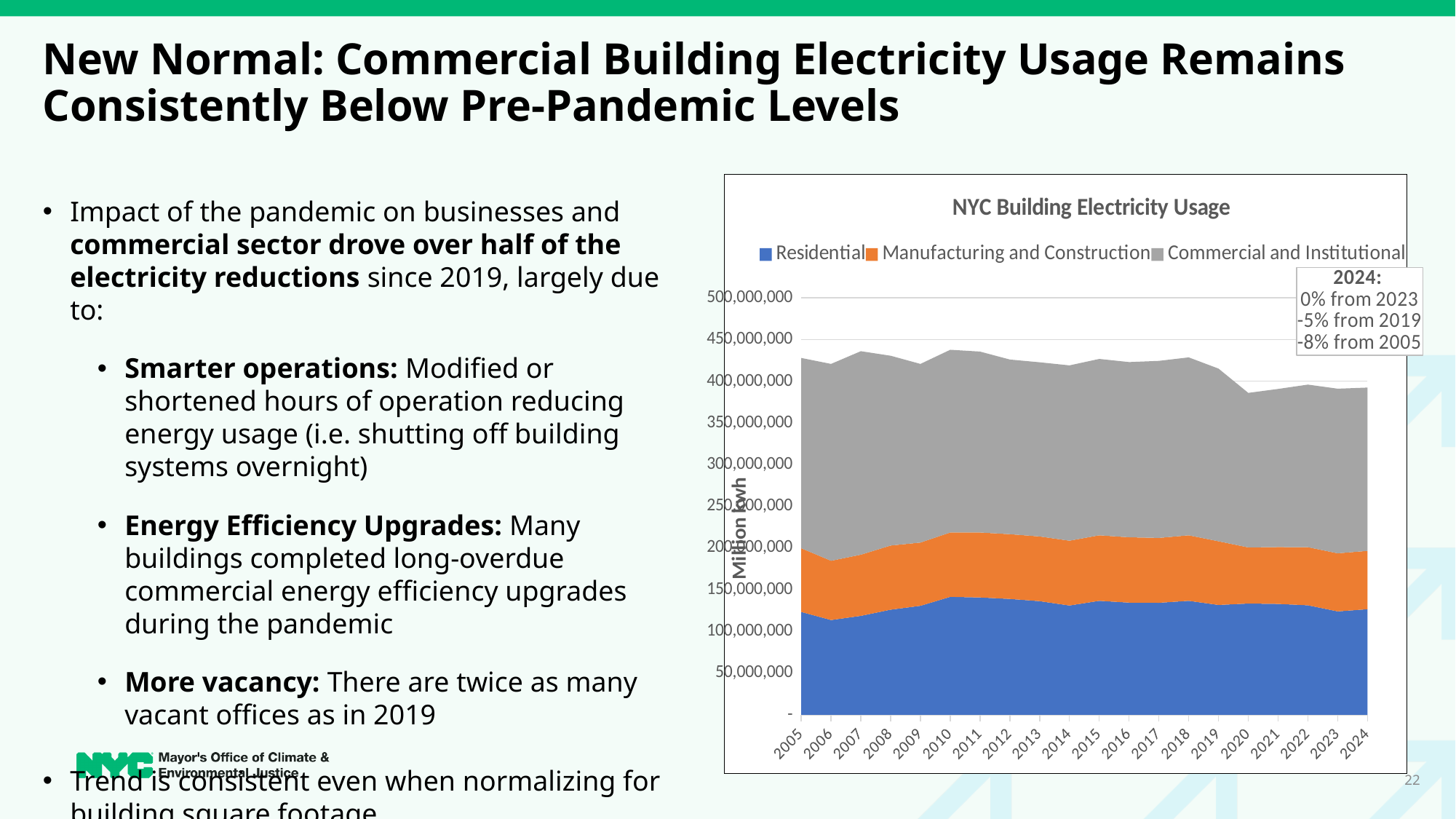
What is the y-axis label on the NYC Building Electricity Usage chart? Million kwh Is the Residential electricity usage in 2006 greater or less than 100,000,000? greater What type of chart is the NYC Building Electricity Usage chart? Stacked area chart Is the total building electricity usage in 2024 greater or less than 400,000,000? less What is the first year shown on the x axis of the NYC Building Electricity Usage chart? 2005 Which series accounts for the largest share of electricity usage in 2024, Residential or Commercial and Institutional? Commercial and Institutional How many years are shown on the x axis of the NYC Building Electricity Usage chart? 20 According to the annotation on the chart, by what percentage did 2024 electricity usage change from 2019? -5% Did total building electricity usage rise or fall from 2019 to 2020? fall Is the Residential electricity usage in 2024 greater or less than 150,000,000? less How many series does the legend of the NYC Building Electricity Usage chart list? 3